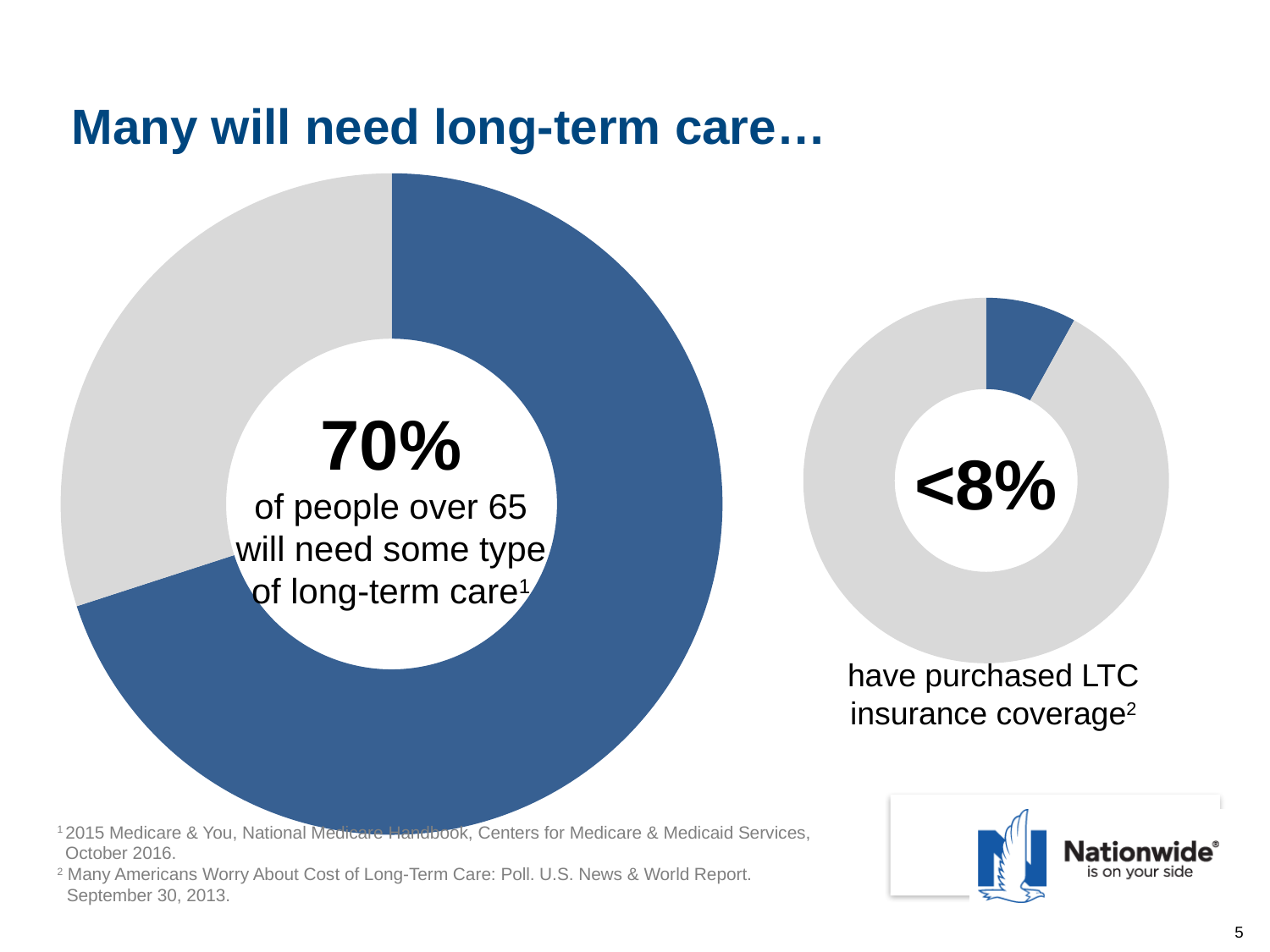
How many charts are shown on the slide? 2 In the left chart, how many segments does the donut have? 2 In the right chart, is the highlighted blue share greater or less than 25%? less In the left chart, is the highlighted blue share greater or less than 50%? greater What kind of chart is used on the left side of the slide? Donut (pie) chart In the right chart, what share of people have purchased LTC insurance coverage? <8% Which chart shows the larger highlighted share: the left chart (need long-term care) or the right chart (purchased LTC insurance)? The left chart What colour is used for the highlighted segment in both donut charts? Blue What is the title of the slide containing the two donut charts? Many will need long-term care… In the left chart, what share of the donut is the blue segment? 70% In the left chart, what percentage of people over 65 will need some type of long-term care? 70%